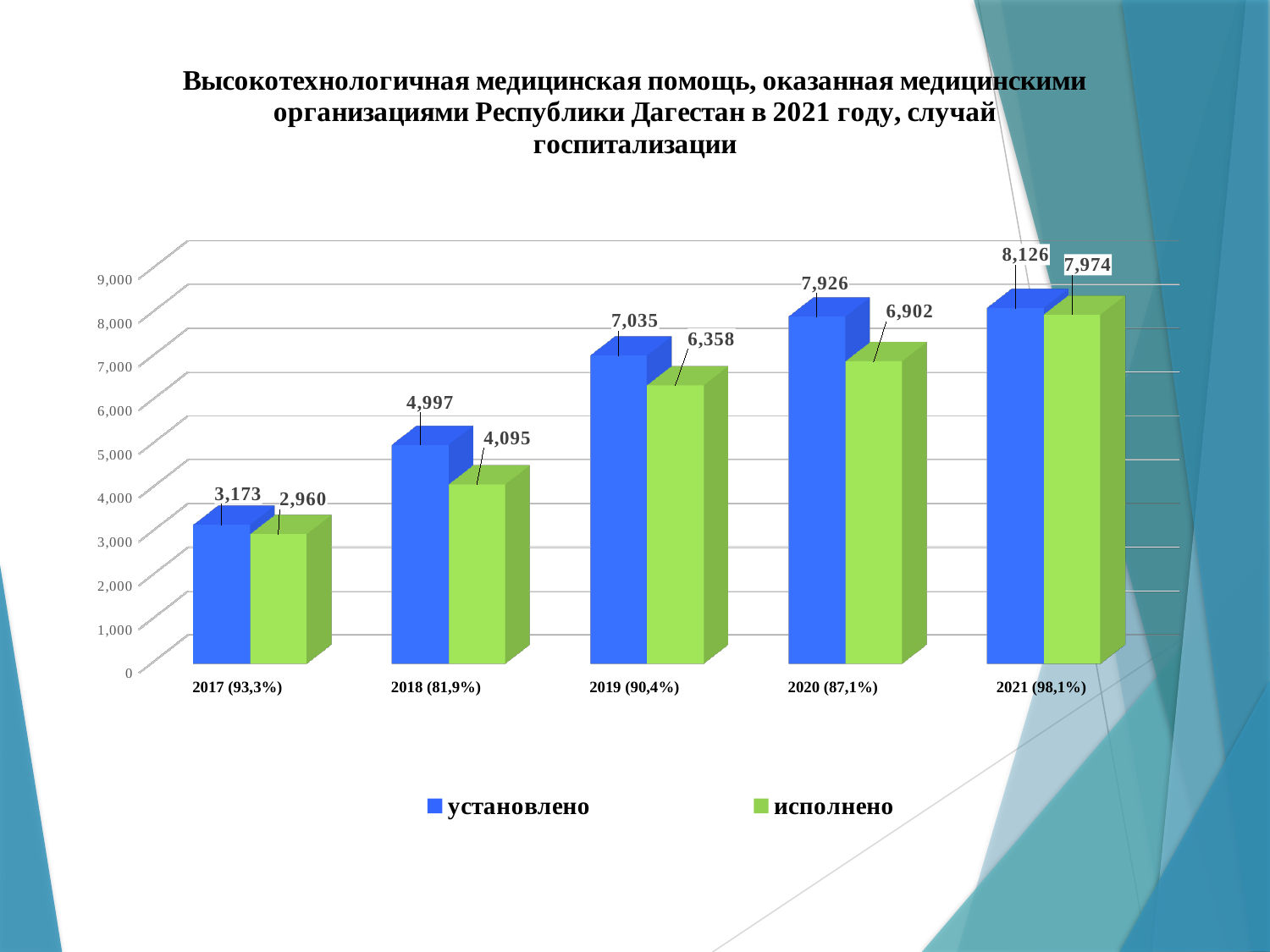
Which year has the lowest исполнено value? 2017 (93,3%) What is the difference between установлено and исполнено in 2018 (81,9%)? 902 Do the исполнено values rise or fall from 2017 to 2021? rise Which year has the highest установлено value? 2021 (98,1%) How many series does the legend list? 2 Which is larger in 2020 (87,1%): установлено or исполнено? установлено What is the value of исполнено for 2021 (98,1%)? 7,974 What is the value of установлено for 2017 (93,3%)? 3,173 What kind of chart is shown on the slide? bar chart Is the value of установлено for 2019 (90,4%) greater or less than 6,000? greater What is the value of исполнено for 2019 (90,4%)? 6,358 How many years are shown on the x axis? 5